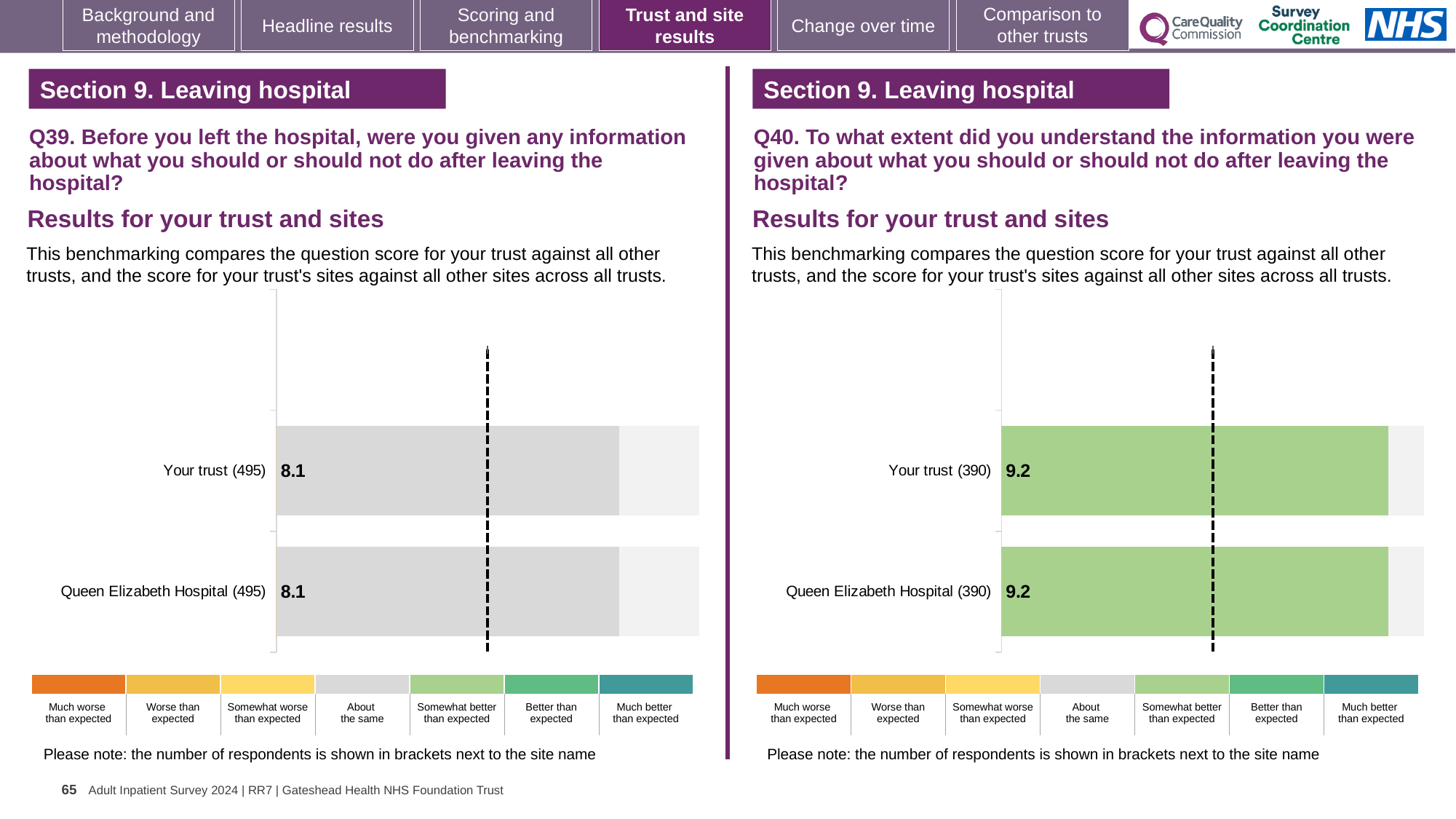
On the Q40 chart (right), how many bars are plotted? 2 On the Q40 chart (right), how many respondents are shown in brackets next to Queen Elizabeth Hospital? 390 On the Q40 chart (right), what is the score for Queen Elizabeth Hospital? 9.2 On the Q39 chart (left), what is the score for Your trust? 8.1 What kind of chart is the Q39 chart (left)? Bar chart On the Q39 chart (left), what is the score for Queen Elizabeth Hospital? 8.1 On the Q39 chart (left), which benchmarking category does the colour of the bars correspond to according to the legend? About the same Is the score for Your trust on the Q40 chart (right) larger or smaller than the score for Your trust on the Q39 chart (left)? Larger On the Q39 chart (left), how many respondents are shown in brackets next to Your trust? 495 On the Q39 chart (left), what is the difference between the score for Your trust and the score for Queen Elizabeth Hospital? 0 On the Q40 chart (right), what is the score for Your trust? 9.2 On the Q40 chart (right), which benchmarking category does the colour of the bars correspond to according to the legend? Somewhat better than expected